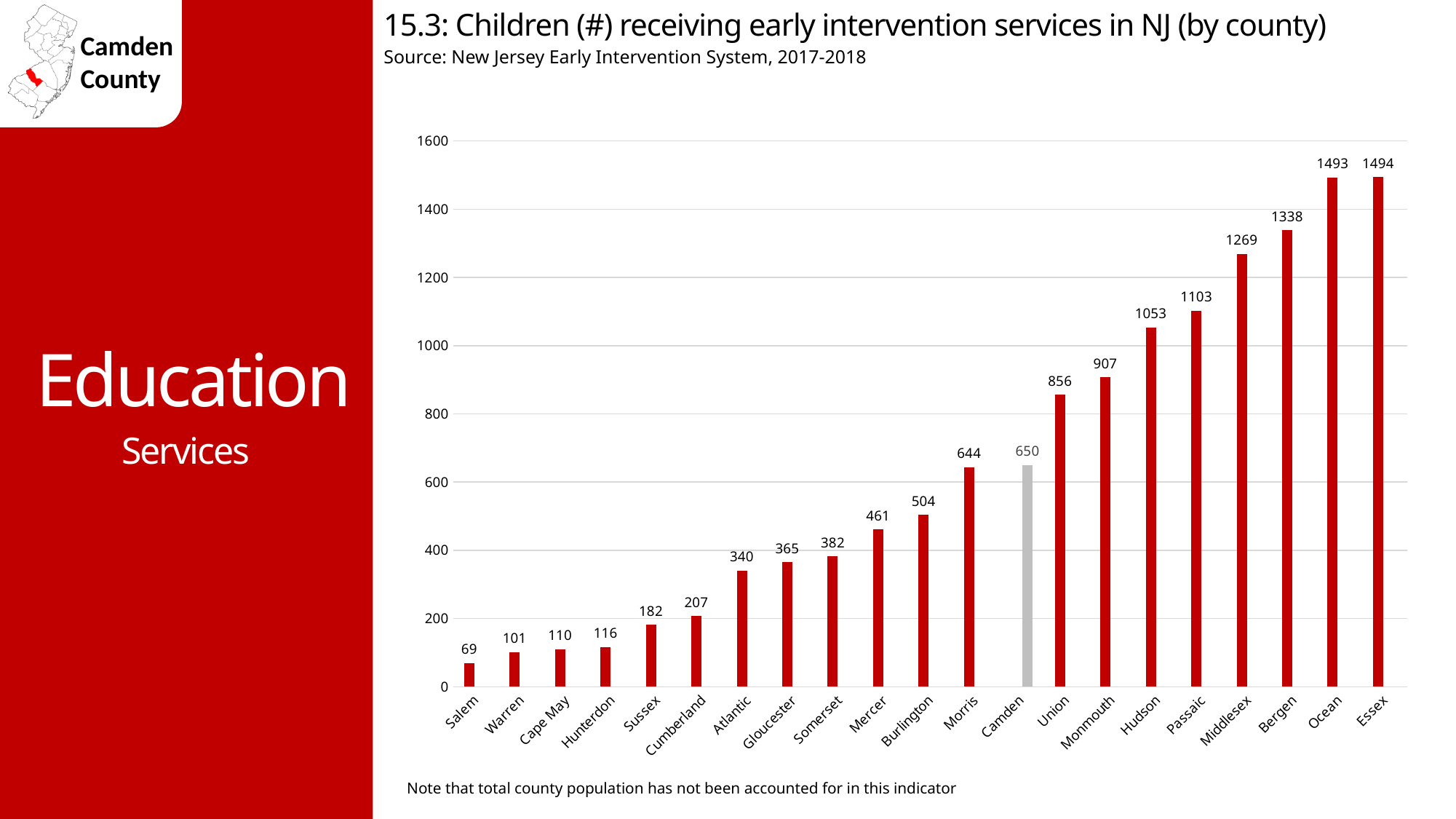
Which county has a higher value, Morris or Mercer? Morris What is the difference between the values for Union and Camden? 206 What is the value shown for Cumberland County? 207 Which county's bar is shown in grey rather than red? Camden Which county has the lowest number of children receiving early intervention services? Salem What is the value shown for Bergen County? 1338 What is the difference between the values for Middlesex and Passaic? 166 How many children received early intervention services in Camden County? 650 How many counties are shown on the chart? 21 Is the value for Atlantic County greater or less than 400? less What kind of chart is shown on the slide? Bar chart Which county has a higher value, Hudson or Monmouth? Hudson